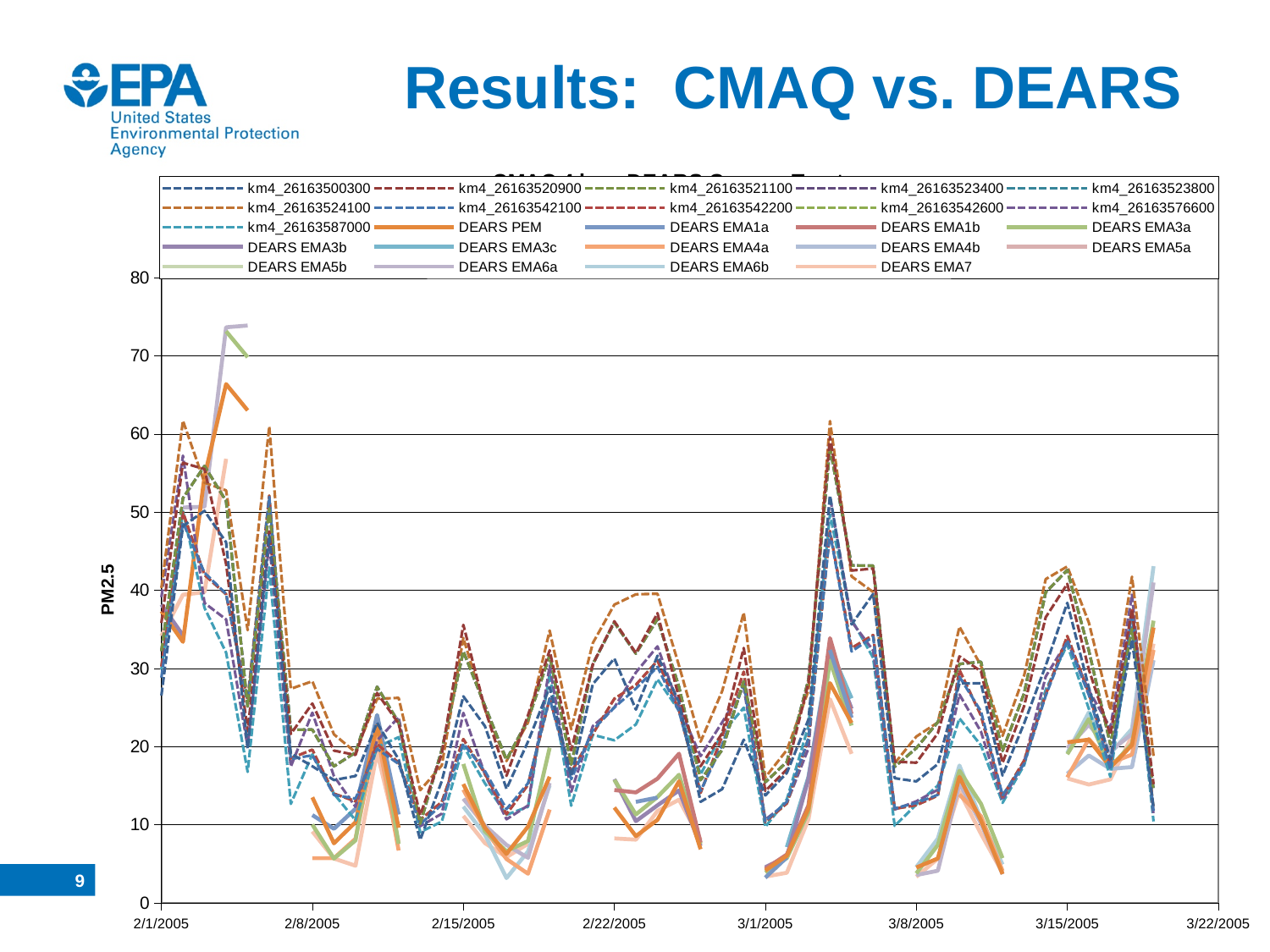
What is the label on the vertical axis of the chart? PM2.5 What kind of chart is shown on the slide? line chart Is the peak of the spike that occurs shortly after 3/1/2005 greater or less than 50? greater Is the highest PM2.5 value plotted on the chart greater or less than 70? greater How many series does the chart's legend list? 24 What is the highest tick value shown on the vertical axis? 80 How many date labels are shown along the horizontal axis? 8 How many legend entries begin with "km4_"? 11 Is the lowest PM2.5 value plotted on the chart greater or less than 10? less How many legend entries begin with "DEARS"? 13 What is the first date label on the horizontal axis? 2/1/2005 What is the last date label on the horizontal axis? 3/22/2005